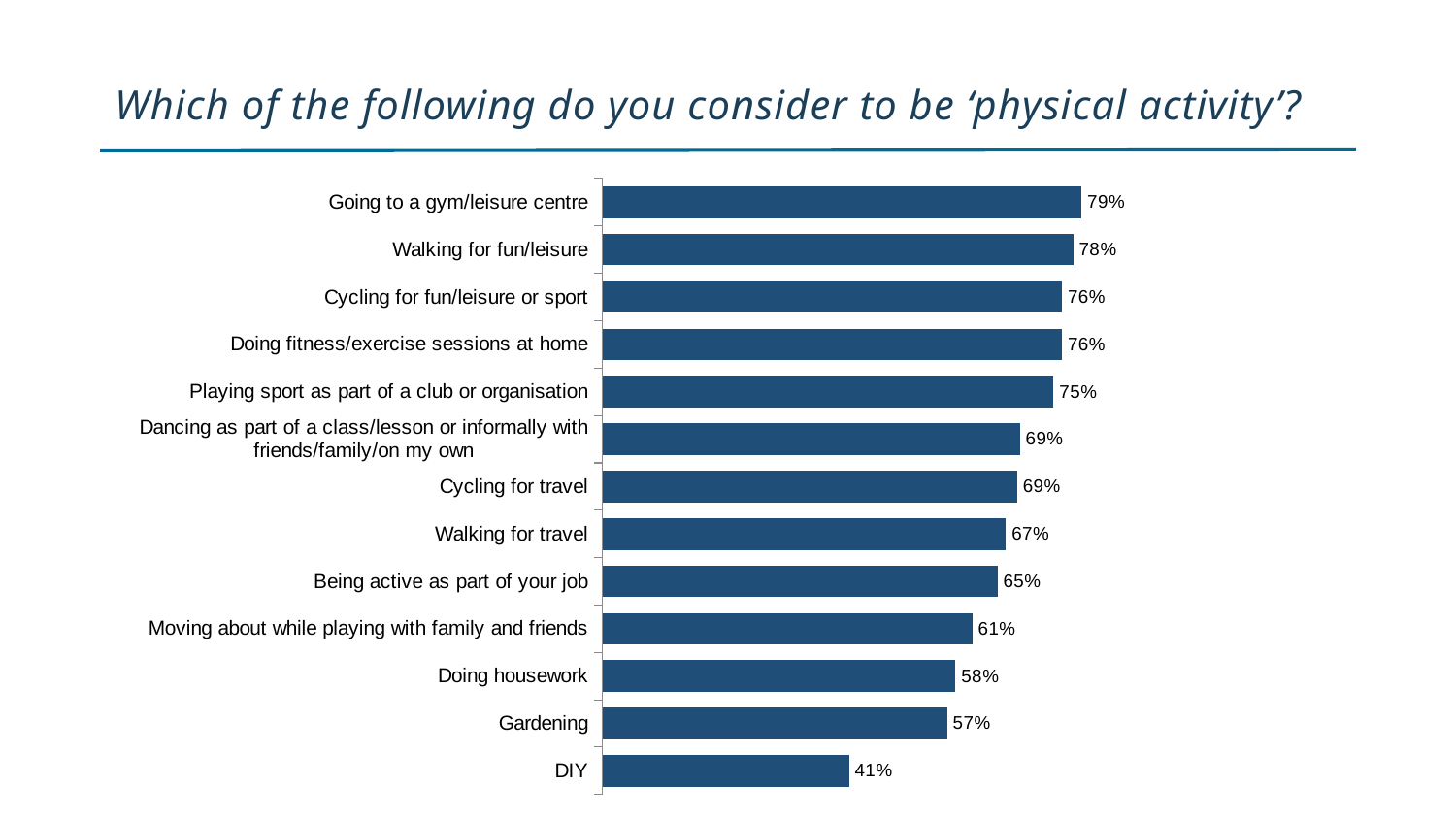
What is the difference between the values for Going to a gym/leisure centre and DIY? 38 percentage points Which category has the lowest value? DIY Which is larger, the value for Cycling for travel or the value for Being active as part of your job? Cycling for travel What kind of chart is shown on the slide? Bar chart Which category has the highest value? Going to a gym/leisure centre What is the value shown for Moving about while playing with family and friends? 61% What is the title of the chart? Which of the following do you consider to be 'physical activity'? How many categories are shown in the chart? 13 What is the value shown for Gardening? 57% What is the value shown for Walking for travel? 67% What percentage of respondents consider going to a gym/leisure centre to be physical activity? 79% What is the difference between the values for Doing housework and Gardening? 1 percentage point